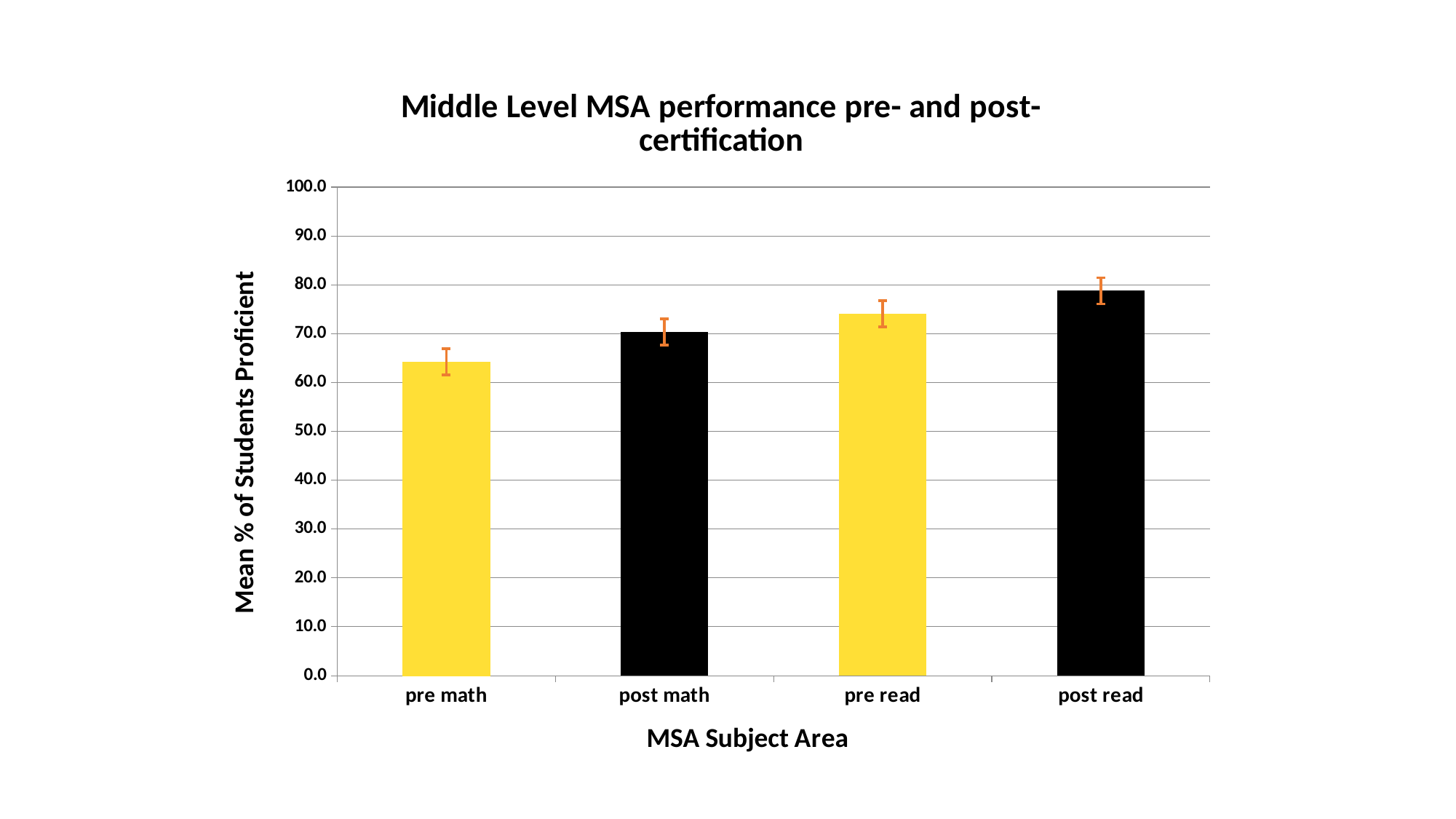
What is the title of the chart? Middle Level MSA performance pre- and post-certification What type of chart is shown on the slide? bar chart Is the value for pre math greater or less than 70.0? less Do the bar values generally rise or fall from left to right along the x axis? rise Which category has the lowest mean % of students proficient? pre math How many categories are shown on the x axis of the chart? 4 Which category has the highest mean % of students proficient? post read Is the value for pre math greater or less than 60.0? greater Is the value for post read greater or less than 70.0? greater Which is larger, the value for post math or the value for pre read? pre read What is the label of the y axis? Mean % of Students Proficient